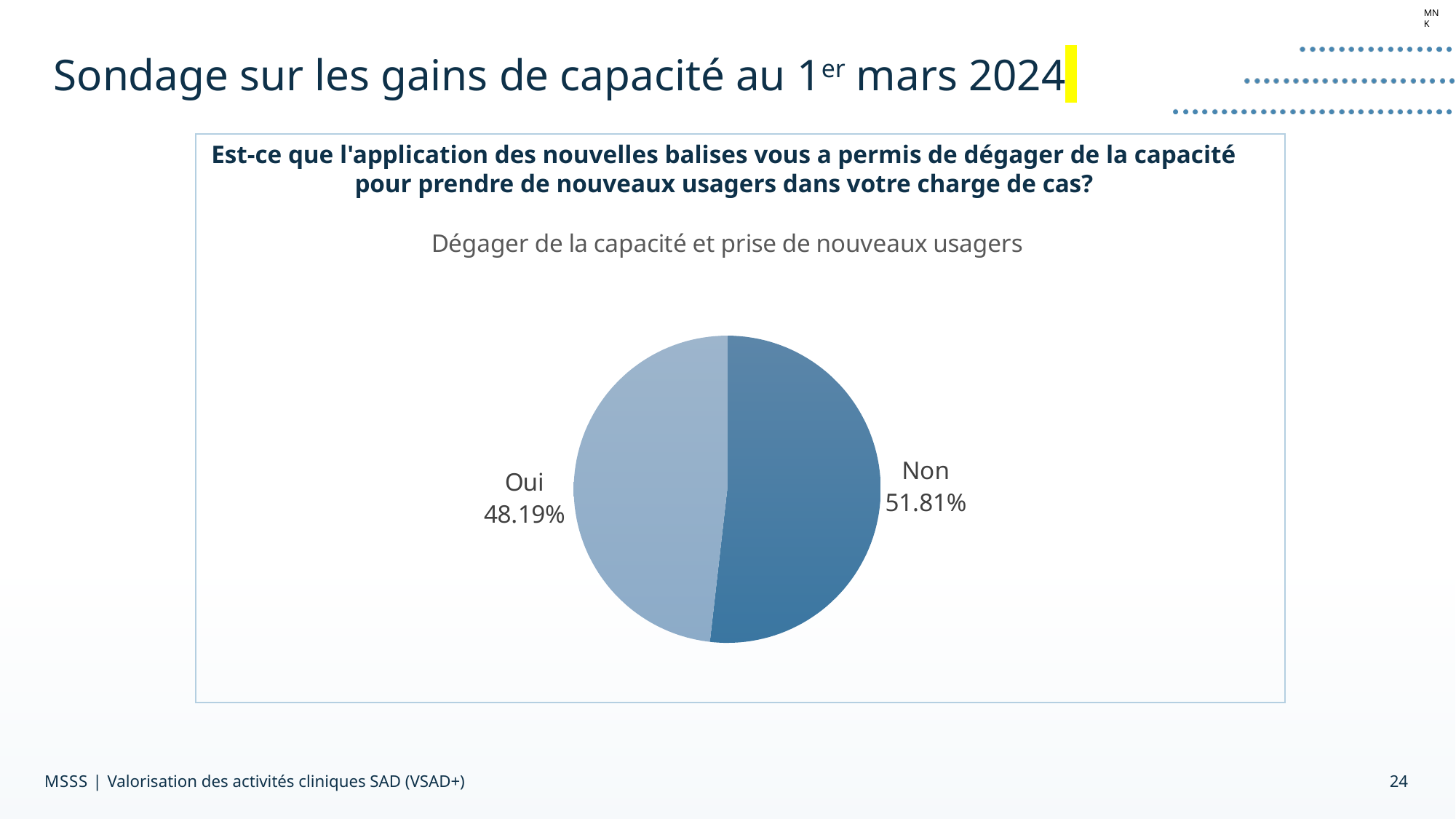
Which response has the smaller share of the pie? Oui What percentage of respondents answered "Non"? 51.81% Which response has the larger share of the pie? Non Is the share for "Oui" larger or smaller than the share for "Non"? smaller What type of chart is shown on the slide? pie chart What is the title of the chart? Dégager de la capacité et prise de nouveaux usagers What is the difference in percentage points between the "Non" and "Oui" shares? 3.62 Which slice is shown in the darker blue colour? Non How many slices does the pie chart have? 2 What percentage of respondents answered "Oui"? 48.19% Is the value for "Non" greater or less than 50%? greater